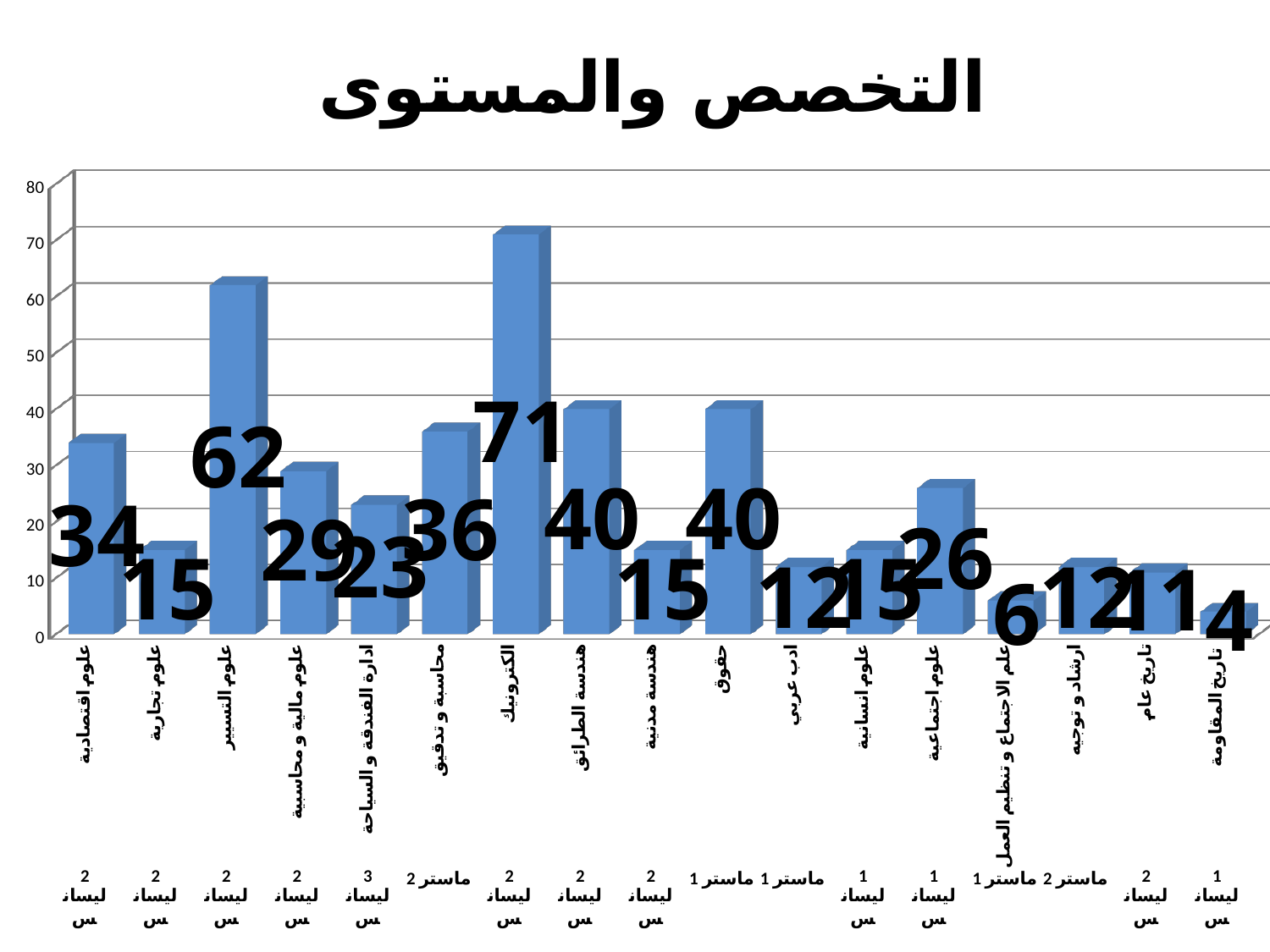
What is the value for علوم اقتصادية? 34 What type of chart is shown on the slide? bar chart What is the value for الكترونيك? 71 What is the difference between the values for الكترونيك and علوم التسيير? 9 Which is larger, the value for محاسبة وتدقيق or the value for علوم مالية ومحاسبية? محاسبة وتدقيق What is the value for علوم التسيير? 62 Which category has the lowest value? تاريخ المقاومة How many categories are shown on the x axis? 17 Which category has the highest value? الكترونيك Is the value for علوم اجتماعية greater or less than 20? greater What is the title of the chart? التخصص والمستوى What is the value for حقوق? 40